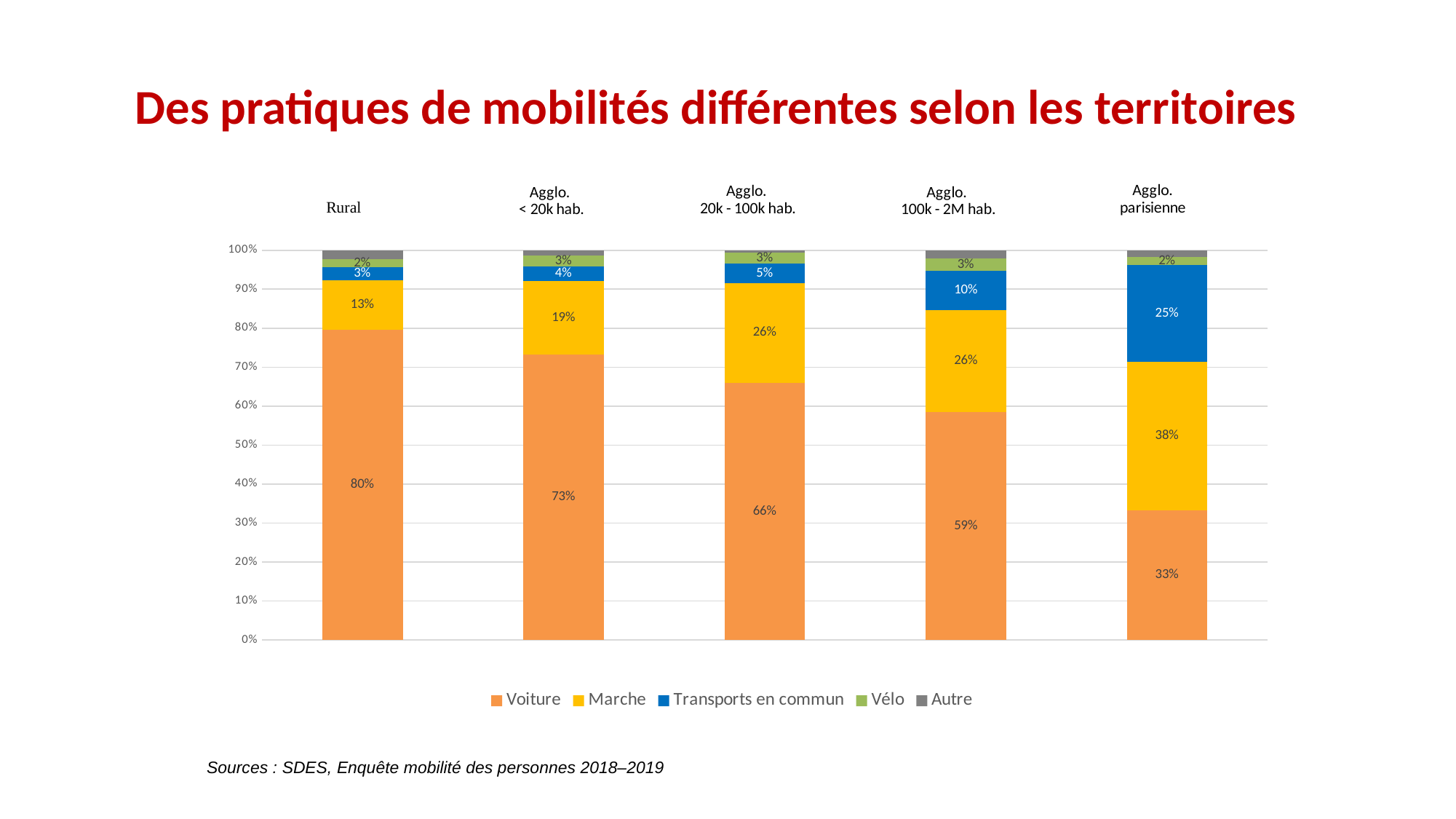
Which series is shown in blue in the legend? Transports en commun How many territory categories are shown on the chart? 5 What share of trips is made by Voiture in the Rural category? 80% What kind of chart is shown on the slide? stacked bar chart How many series does the legend list? 5 Does the Voiture share rise or fall moving from Rural to Agglo. parisienne along the x axis? fall What is the Transports en commun value for Agglo. 100k - 2M hab.? 10% Which category has the highest Voiture share? Rural Which is larger for Agglo. parisienne, the Marche share or the Voiture share? Marche What is the difference between the Voiture share in Rural and in Agglo. parisienne? 47% Which category has the lowest Voiture share? Agglo. parisienne What is the Marche value for Agglo. parisienne? 38%